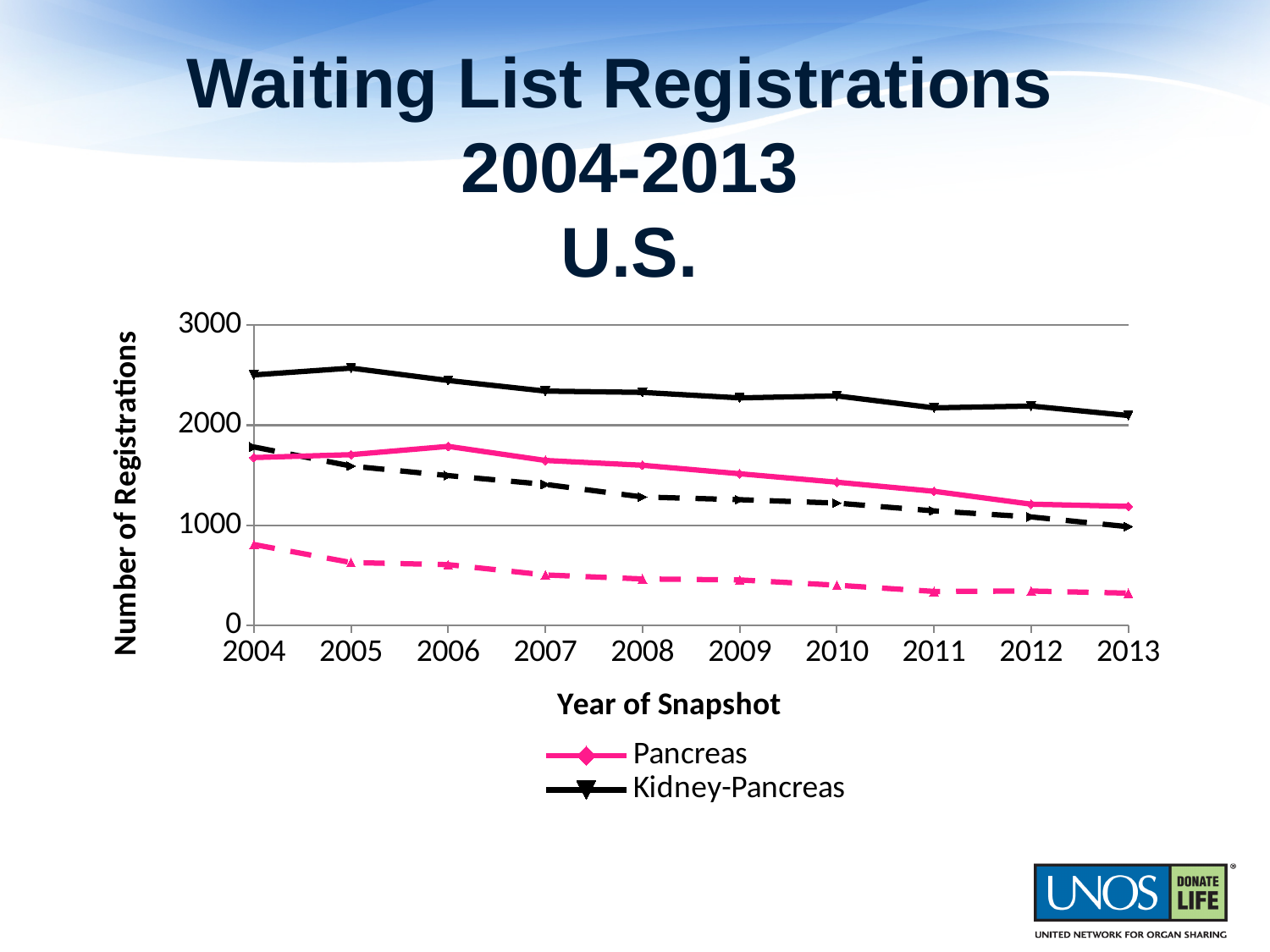
Does the Kidney-Pancreas line rise or fall overall from 2004 to 2013? fall How many years are plotted along the x axis? 10 How many series does the legend list? 2 Is the Kidney-Pancreas value for 2004 greater or less than 2000? greater Is the Pancreas value for 2004 greater or less than 2000? less Is the Pancreas value for 2013 greater or less than 1000? greater What kind of chart is shown on the slide? line chart In which year does the Kidney-Pancreas series reach its highest value? 2005 In 2004, which series has the higher number of registrations, Pancreas or Kidney-Pancreas? Kidney-Pancreas In which year does the Pancreas series reach its highest value? 2006 What is the label of the x axis? Year of Snapshot